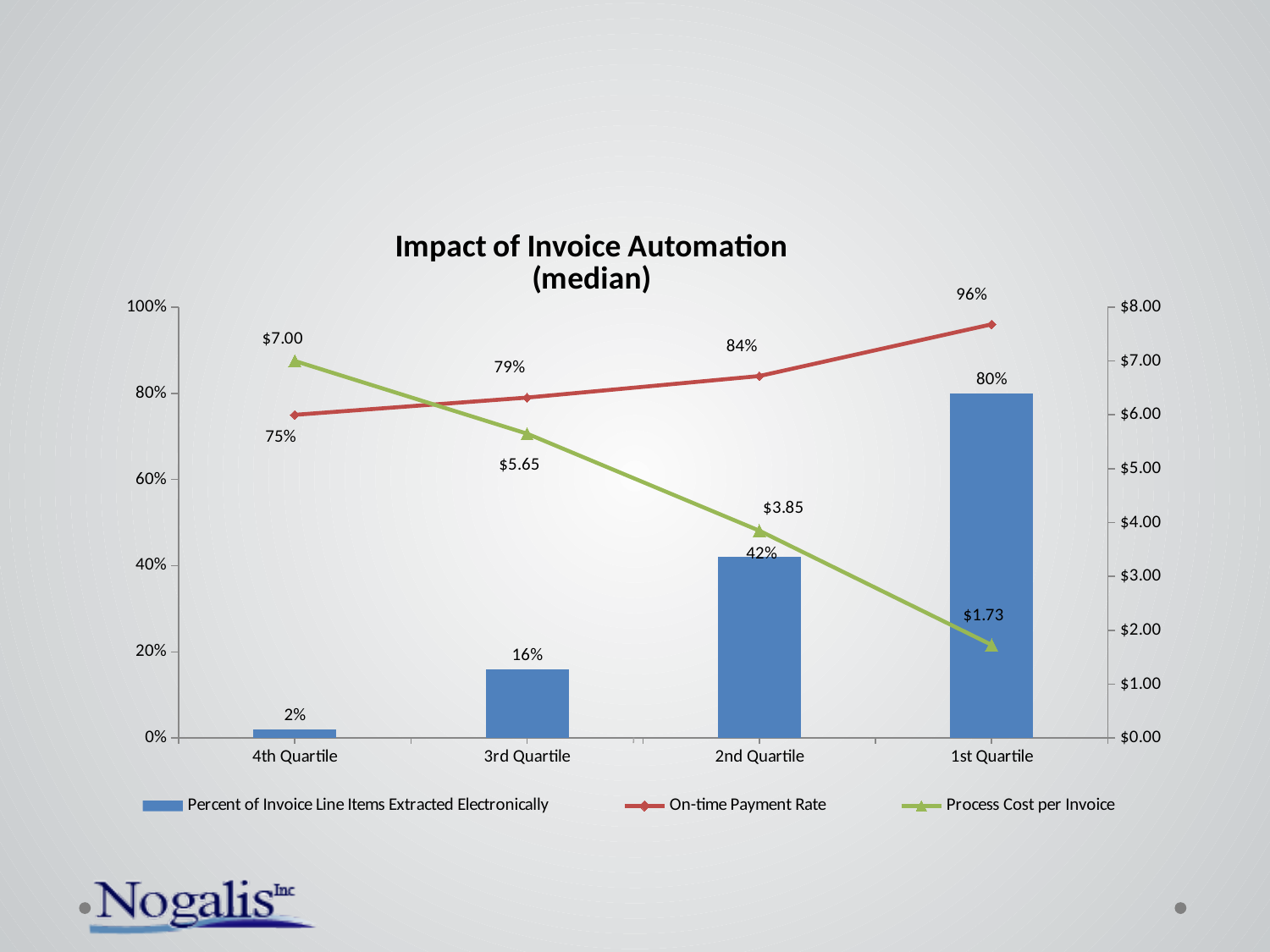
What is the difference in On-time Payment Rate between the 1st Quartile and the 4th Quartile? 21% What is the On-time Payment Rate for the 3rd Quartile? 79% What is the Percent of Invoice Line Items Extracted Electronically for the 2nd Quartile? 42% What is the Process Cost per Invoice for the 4th Quartile? $7.00 What is the difference in Process Cost per Invoice between the 3rd Quartile and the 2nd Quartile? $1.80 Which is larger: the Percent of Invoice Line Items Extracted Electronically for the 3rd Quartile or for the 2nd Quartile? 2nd Quartile What is the title of the chart? Impact of Invoice Automation (median) Which quartile has the lowest Process Cost per Invoice? 1st Quartile How many quartile categories are shown on the x axis? 4 Which quartile has the highest Percent of Invoice Line Items Extracted Electronically? 1st Quartile How many series does the legend list? 3 Does the Process Cost per Invoice rise or fall from the 4th Quartile to the 1st Quartile? fall